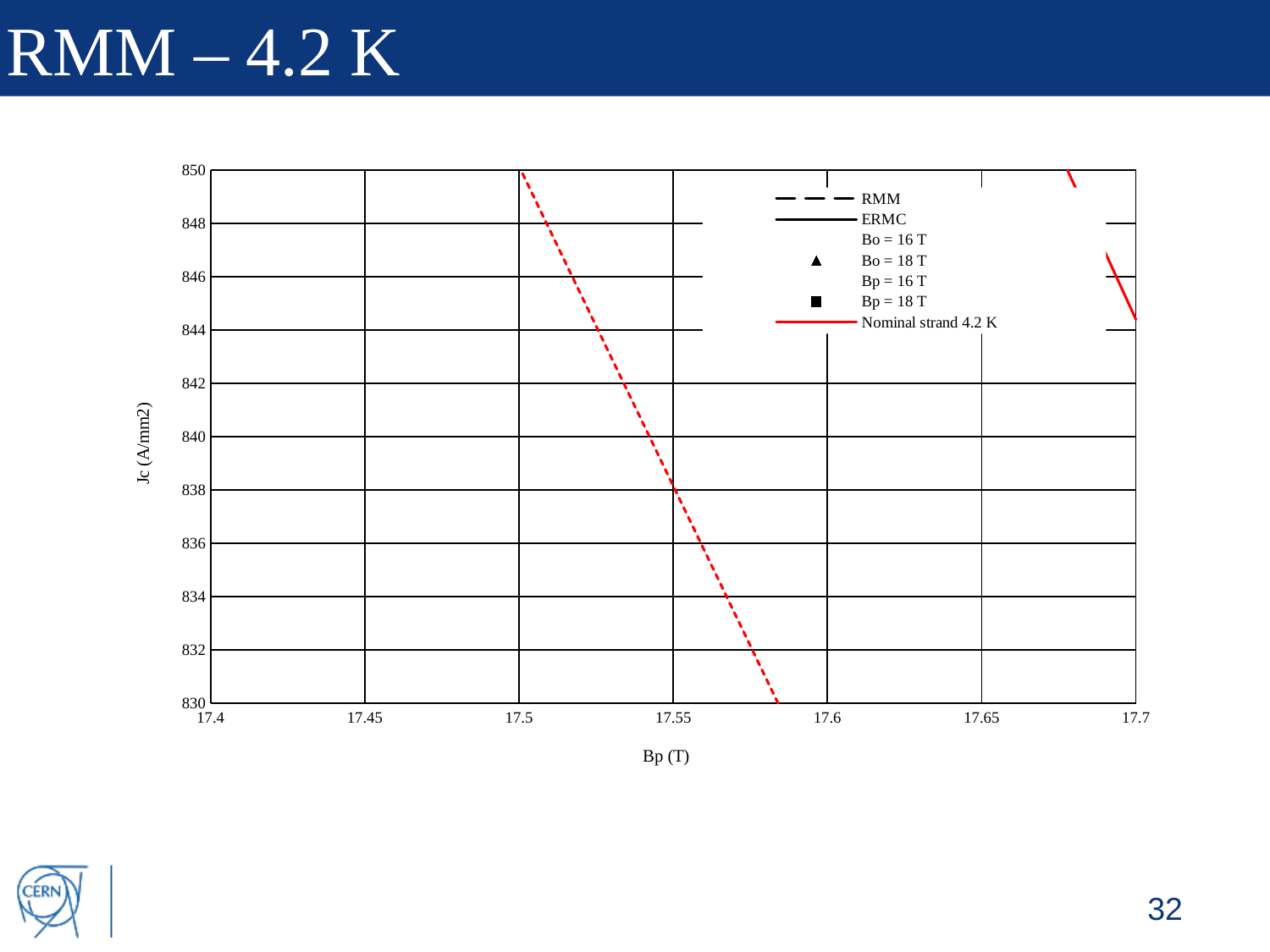
What is the label of the x axis? Bp (T) At Bp = 17.7 T, is the value of the solid red Nominal strand 4.2 K line greater or less than 842? greater How many tick labels are shown on the x axis? 7 What is the label of the y axis? Jc (A/mm2) At Bp = 17.7 T, is the value of the solid red Nominal strand 4.2 K line greater or less than 848? less How many entries does the chart legend list? 7 What kind of chart is shown on the slide? line chart